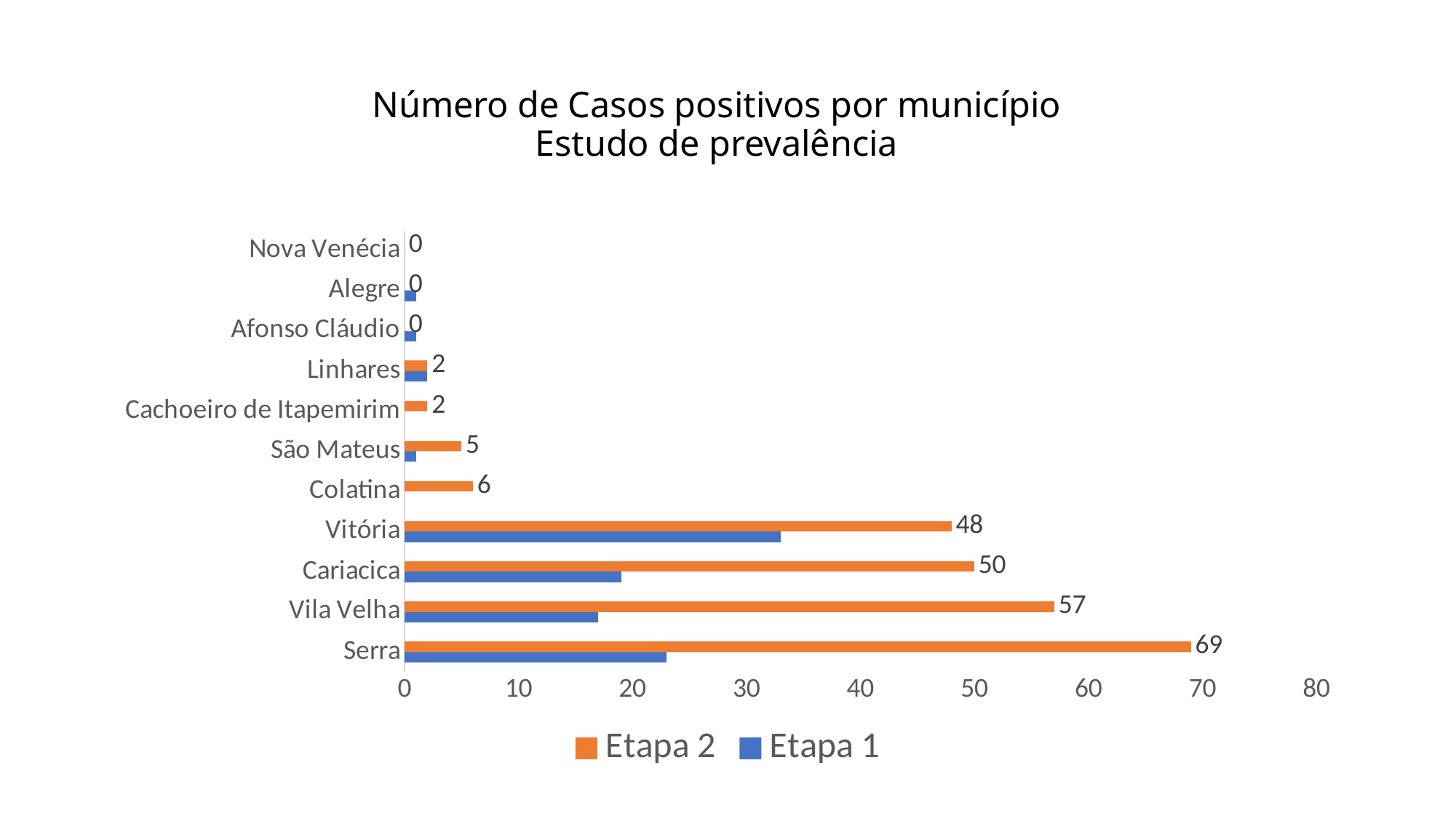
How many municipalities are shown on the chart? 11 Is the Etapa 1 value for Serra greater or less than 30? less What kind of chart is shown? Bar chart What is the Etapa 2 value for Colatina? 6 Is the Etapa 1 value for Vitória greater or less than 30? greater How many series does the legend list? 2 Which is larger for Etapa 2: Cariacica or Vitória? Cariacica Which municipality has the highest Etapa 2 value? Serra What is the Etapa 2 value for Serra? 69 What is the Etapa 2 value for Vila Velha? 57 Which colour represents Etapa 1 in the legend? Blue What is the difference between the Etapa 2 values for Serra and Vila Velha? 12